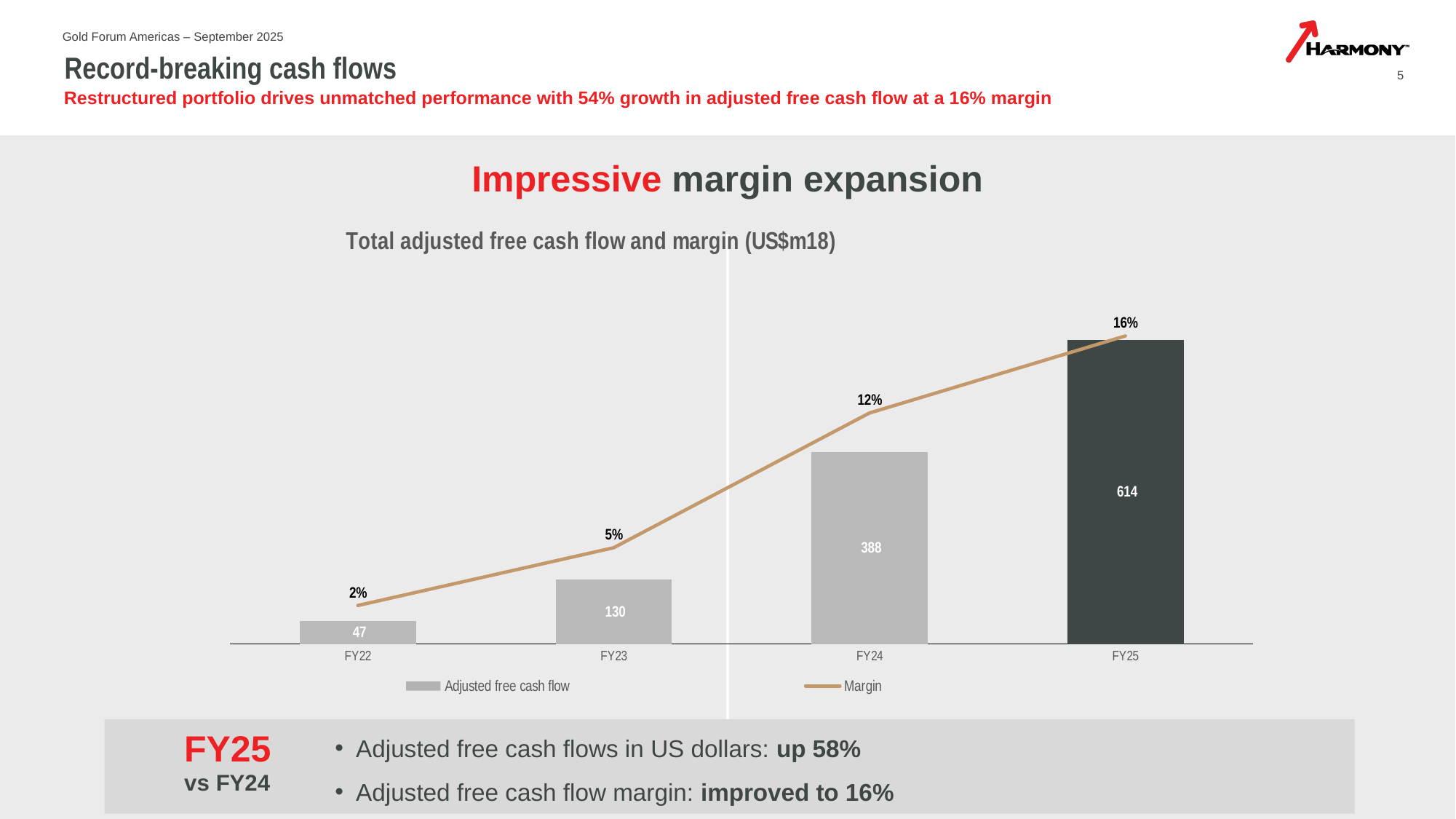
How many years are shown on the x axis? 4 What is the difference in margin between FY24 and FY23? 7% How many series does the legend list? 2 What is the margin for FY23? 5% Which year has the lowest margin? FY22 What is the difference in adjusted free cash flow between FY25 and FY24? 226 What is the title of the chart? Total adjusted free cash flow and margin (US$m18) Which is larger, the adjusted free cash flow for FY23 or for FY24? FY24 Does the margin rise or fall from FY22 to FY25? rise Which year has the highest adjusted free cash flow? FY25 What is the adjusted free cash flow for FY24? 388 What is the adjusted free cash flow for FY22? 47